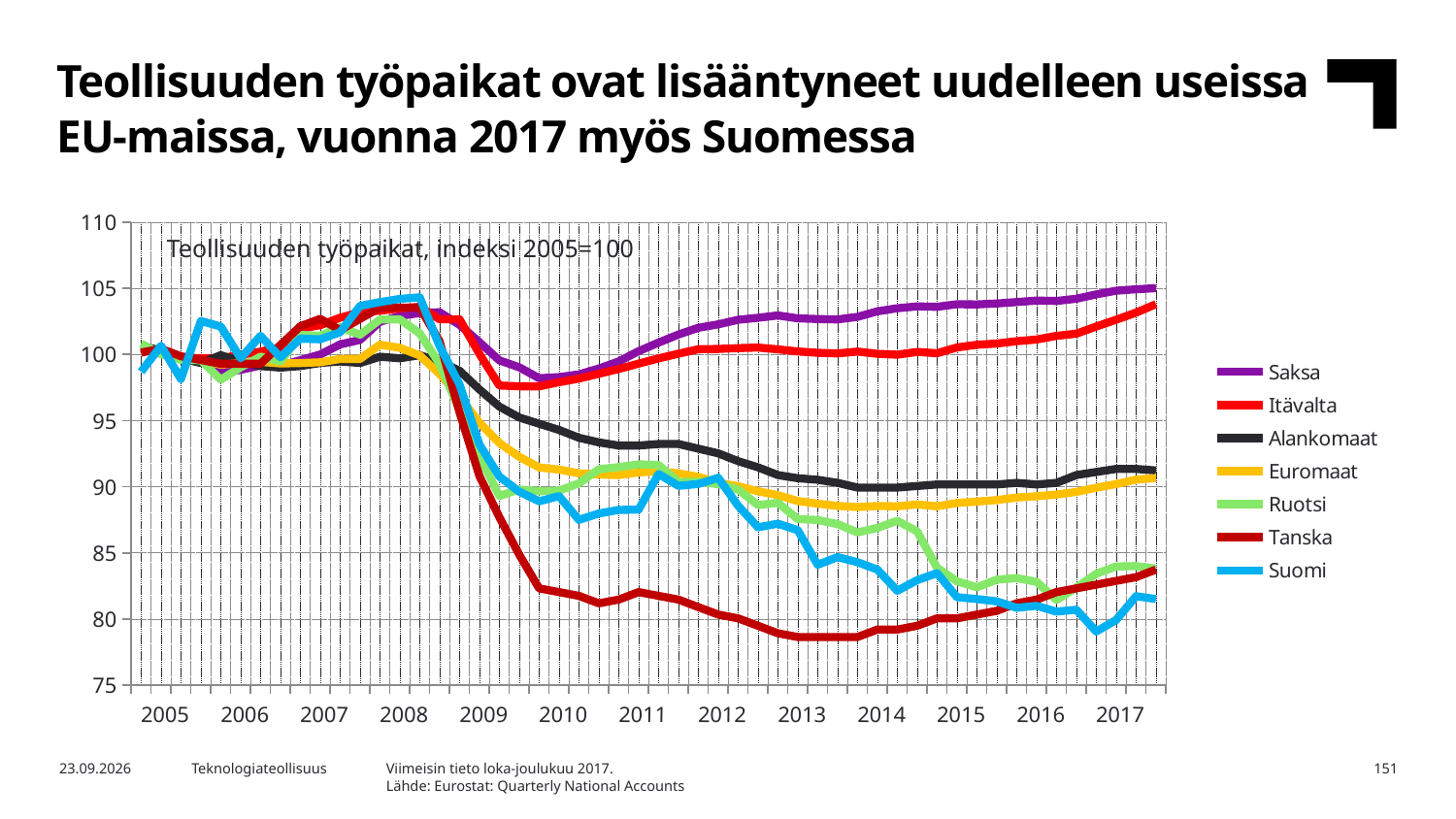
Is the value for Tanska in 2013 greater or less than 80? less Is the value for Alankomaat in 2015 greater or less than 95? less Is the value for Saksa in 2017 greater or less than 100? greater Which series has the highest value at the end of 2017? Saksa Which series has the lowest value in 2013? Tanska At the end of 2017, which is higher, Saksa or Itävalta? Saksa Which colour is used for the Suomi line? light blue What is the title printed inside the chart area? Teollisuuden työpaikat, indeksi 2005=100 Does the Tanska line rise or fall between 2008 and 2013? fall How many series does the legend list? 7 How many years are labelled on the x axis? 13 What kind of chart is shown on the slide? line chart